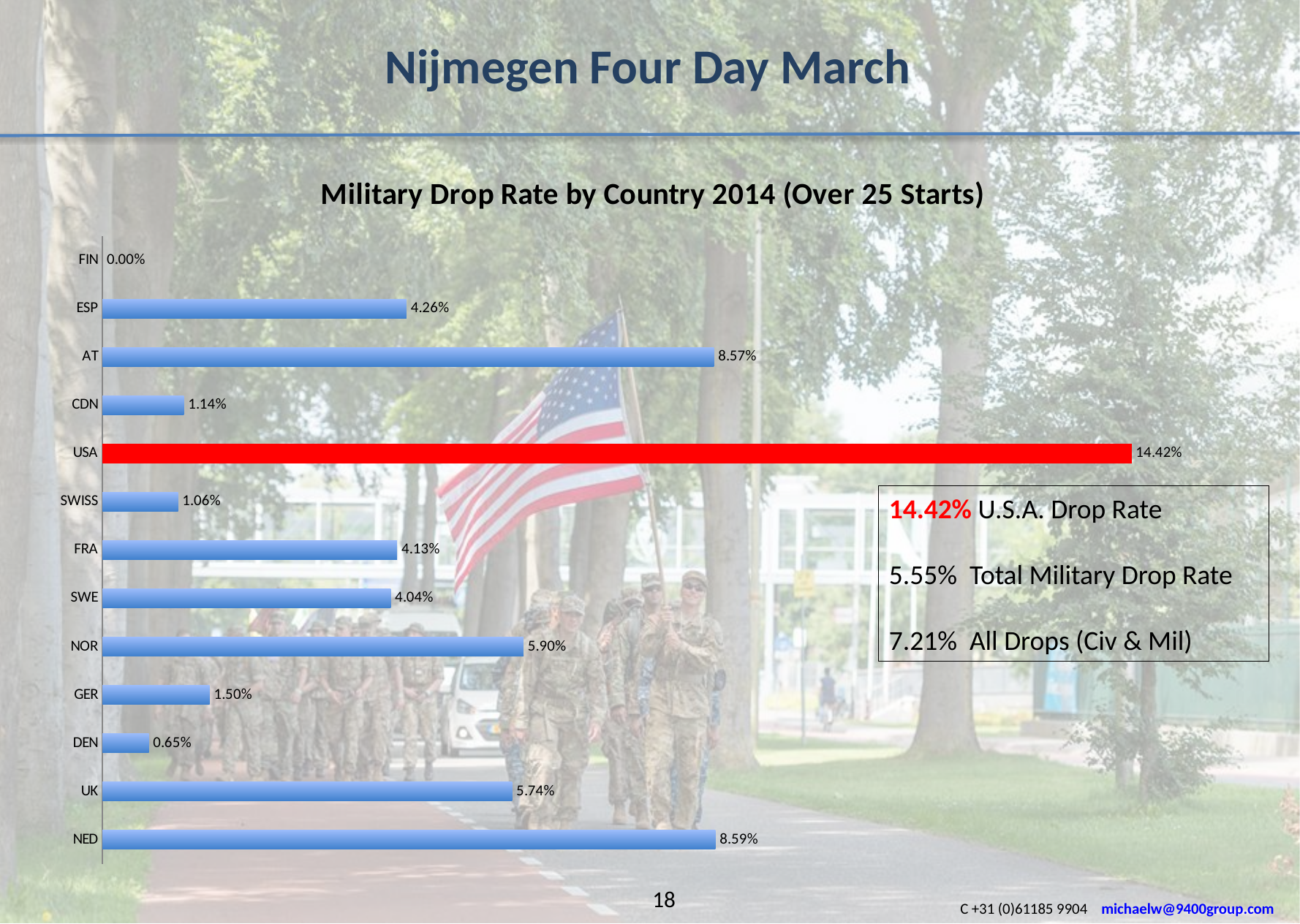
What is the military drop rate for NED? 8.59% Which country's bar is coloured red in the chart? USA Which has a higher drop rate, UK or GER? UK How many countries are shown in the chart? 13 What is the difference between the AT drop rate and the CDN drop rate? 7.43% What is the difference between the USA drop rate and the NED drop rate? 5.83% What is the military drop rate for DEN? 0.65% What is the military drop rate for NOR? 5.90% Which country has the lowest military drop rate? FIN Which country has the highest military drop rate? USA What type of chart is shown on the slide? Bar chart What is the military drop rate for the USA? 14.42%